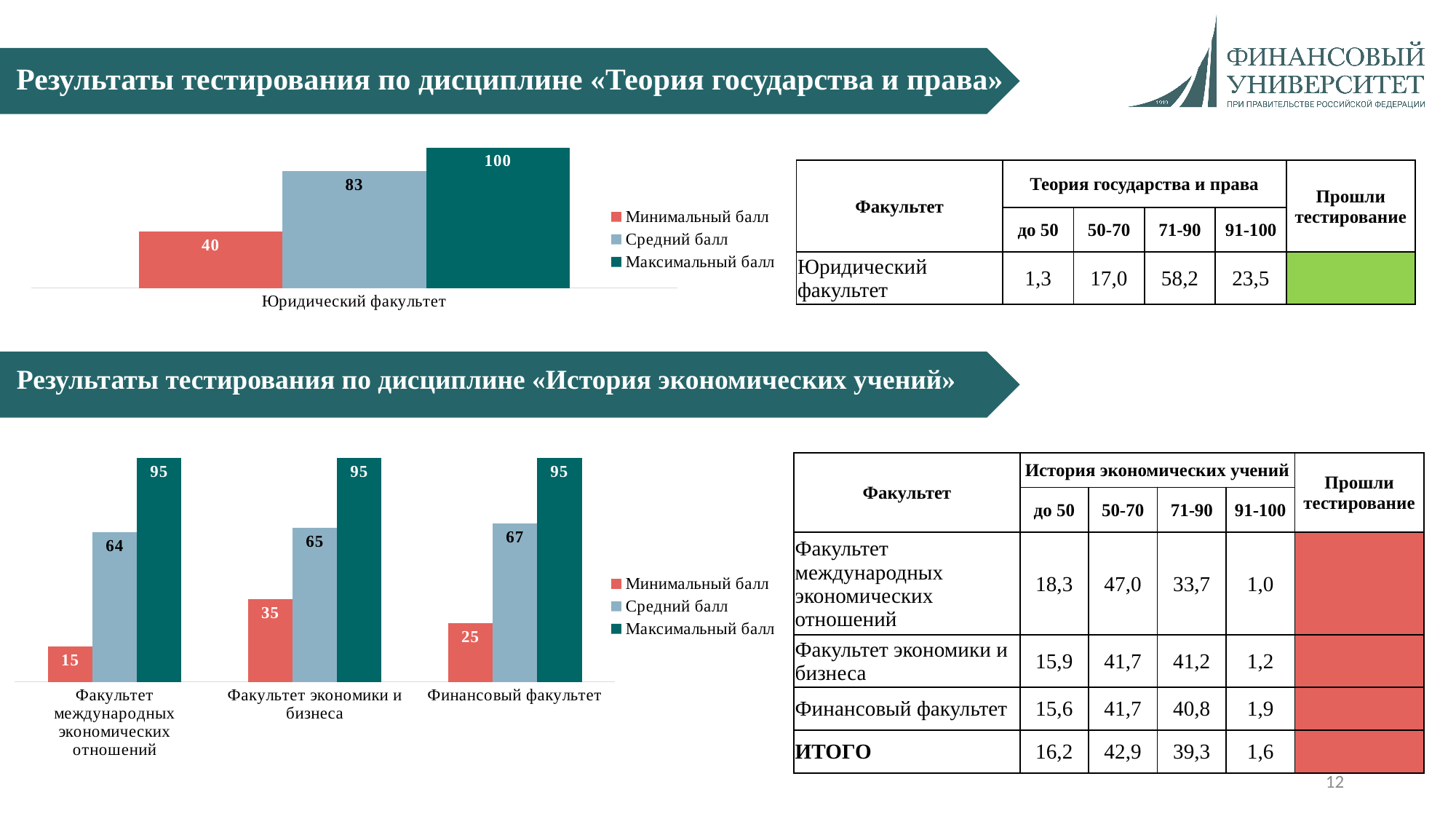
In the bottom chart (История экономических учений), what is the difference between the Минимальный балл of Факультет экономики и бизнеса and that of Финансовый факультет? 10 In the bottom chart (История экономических учений), which faculty has the lowest Минимальный балл? Факультет международных экономических отношений How many series does the legend of the top chart (Теория государства и права) list? 3 In the top chart (Теория государства и права), what is the Средний балл for Юридический факультет? 83 What kind of chart is the bottom chart (История экономических учений)? Bar chart In the bottom chart (История экономических учений), which colour represents Максимальный балл in the legend? Dark teal In the bottom chart (История экономических учений), what is the Минимальный балл for Факультет экономики и бизнеса? 35 In the bottom chart (История экономических учений), which faculty has the highest Средний балл? Финансовый факультет In the bottom chart (История экономических учений), what is the Средний балл for Финансовый факультет? 67 In the top chart (Теория государства и права), what is the difference between the Максимальный балл and the Минимальный балл for Юридический факультет? 60 In the bottom chart (История экономических учений), how many faculties are shown on the x axis? 3 In the top chart (Теория государства и права), what is the Максимальный балл for Юридический факультет? 100